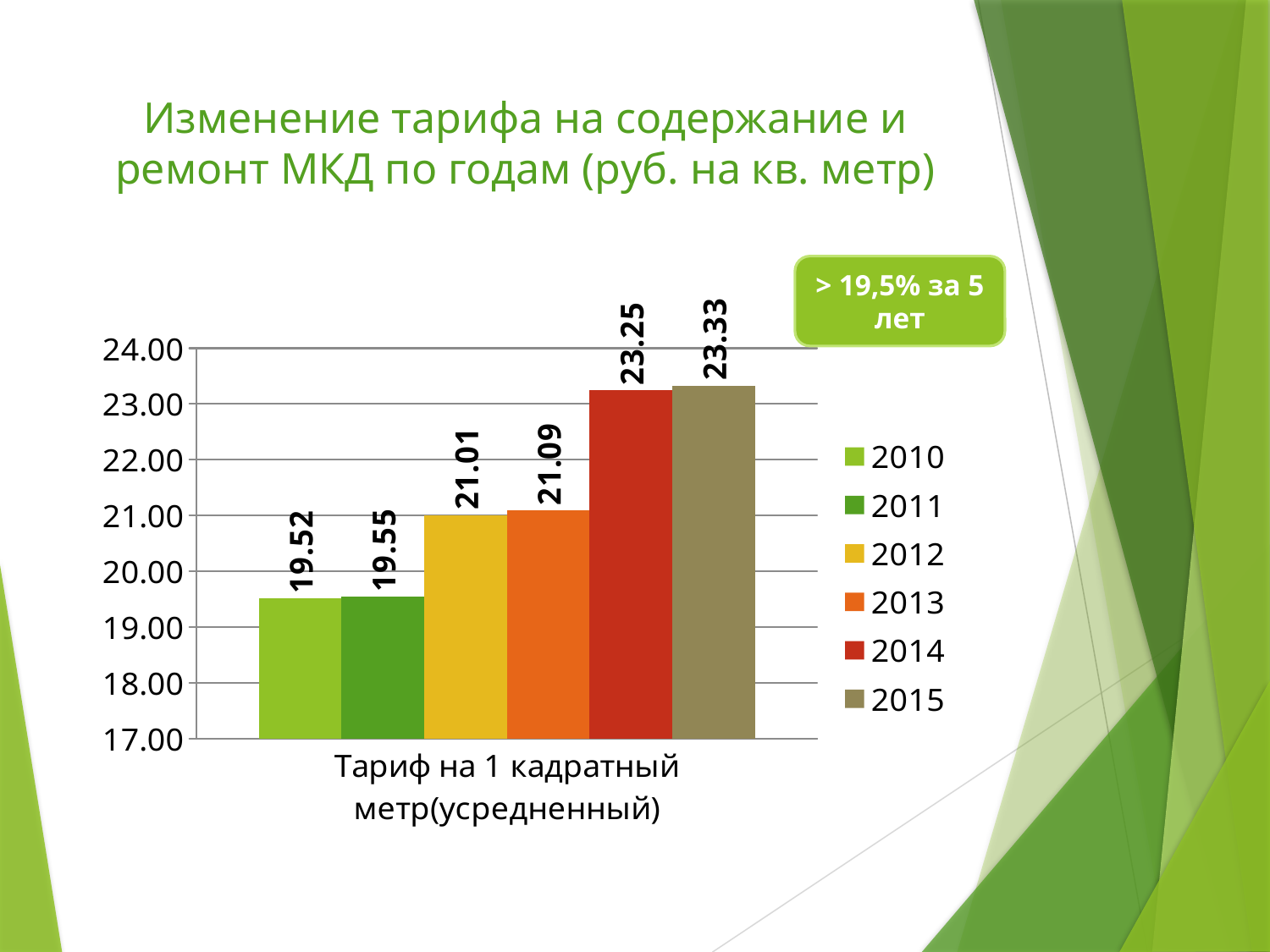
What is the difference between the values for 2014 and 2013? 2.16 Which year has the lowest value? 2010 What kind of chart is shown on the slide? bar chart Do the values rise or fall from 2010 to 2015? rise Which is larger, the value for 2012 or the value for 2014? 2014 Is the value for 2011 greater or less than 20.00? less What is the value for 2010? 19.52 What is the difference between the values for 2015 and 2010? 3.81 What is the value for 2015? 23.33 What is the value for 2013? 21.09 Which year has the highest value? 2015 How many series does the legend list? 6